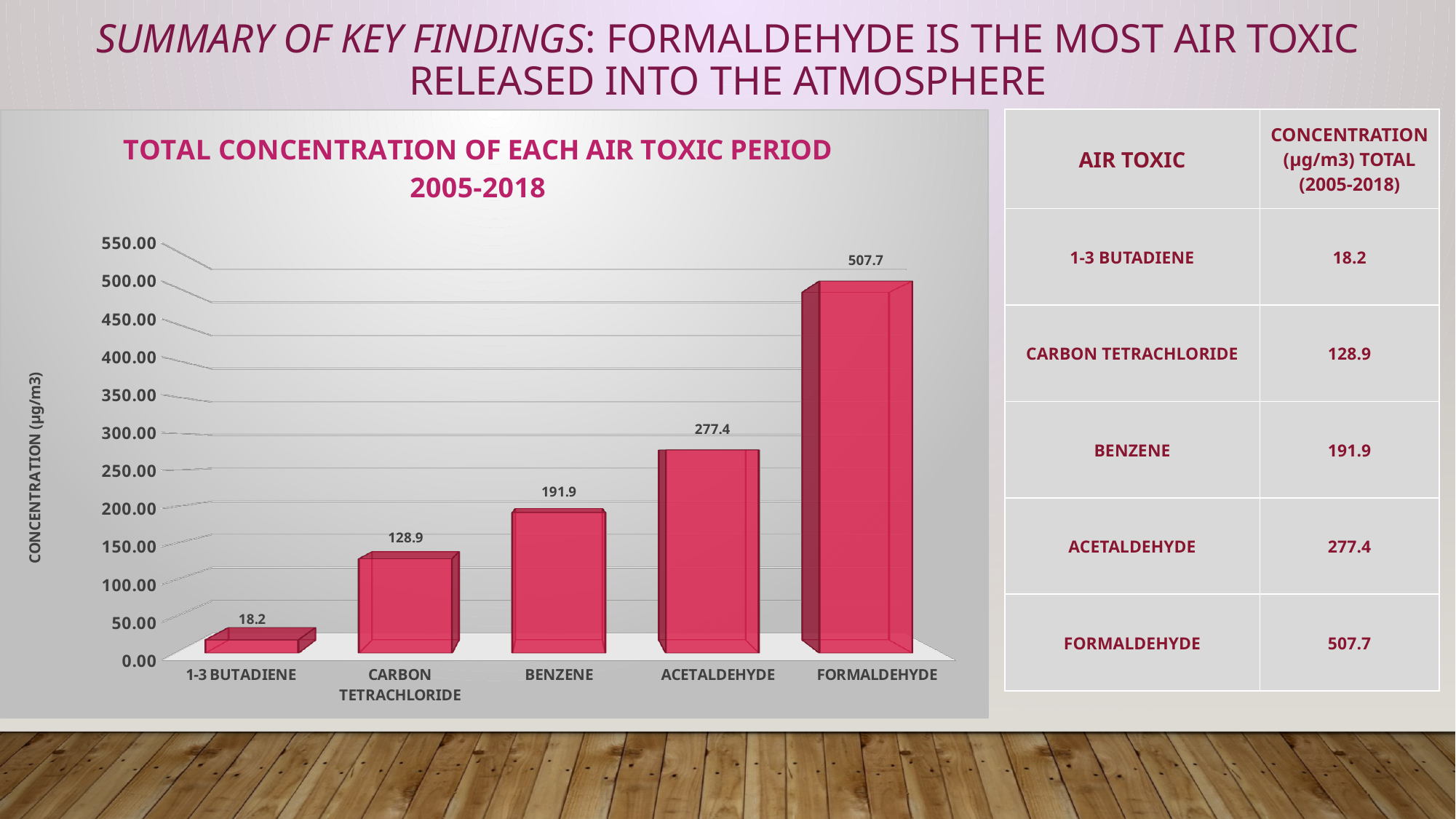
What is the difference between the total concentration of Benzene and Carbon Tetrachloride? 63.0 How many air toxics are shown in the chart? 5 Which air toxic has the lowest total concentration in the chart? 1-3 Butadiene What is the total concentration for Benzene in the chart? 191.9 Which air toxic has the highest total concentration in the chart? Formaldehyde What is the total concentration for 1-3 Butadiene in the chart? 18.2 Which has a higher total concentration, Acetaldehyde or Benzene? Acetaldehyde Is the value for Carbon Tetrachloride greater or less than 150.00? less What is the title of the chart? Total Concentration of Each Air Toxic Period 2005-2018 What is the total concentration for Formaldehyde in the chart? 507.7 What is the difference between the total concentration of Formaldehyde and Acetaldehyde? 230.3 What kind of chart is shown on the slide? Bar chart